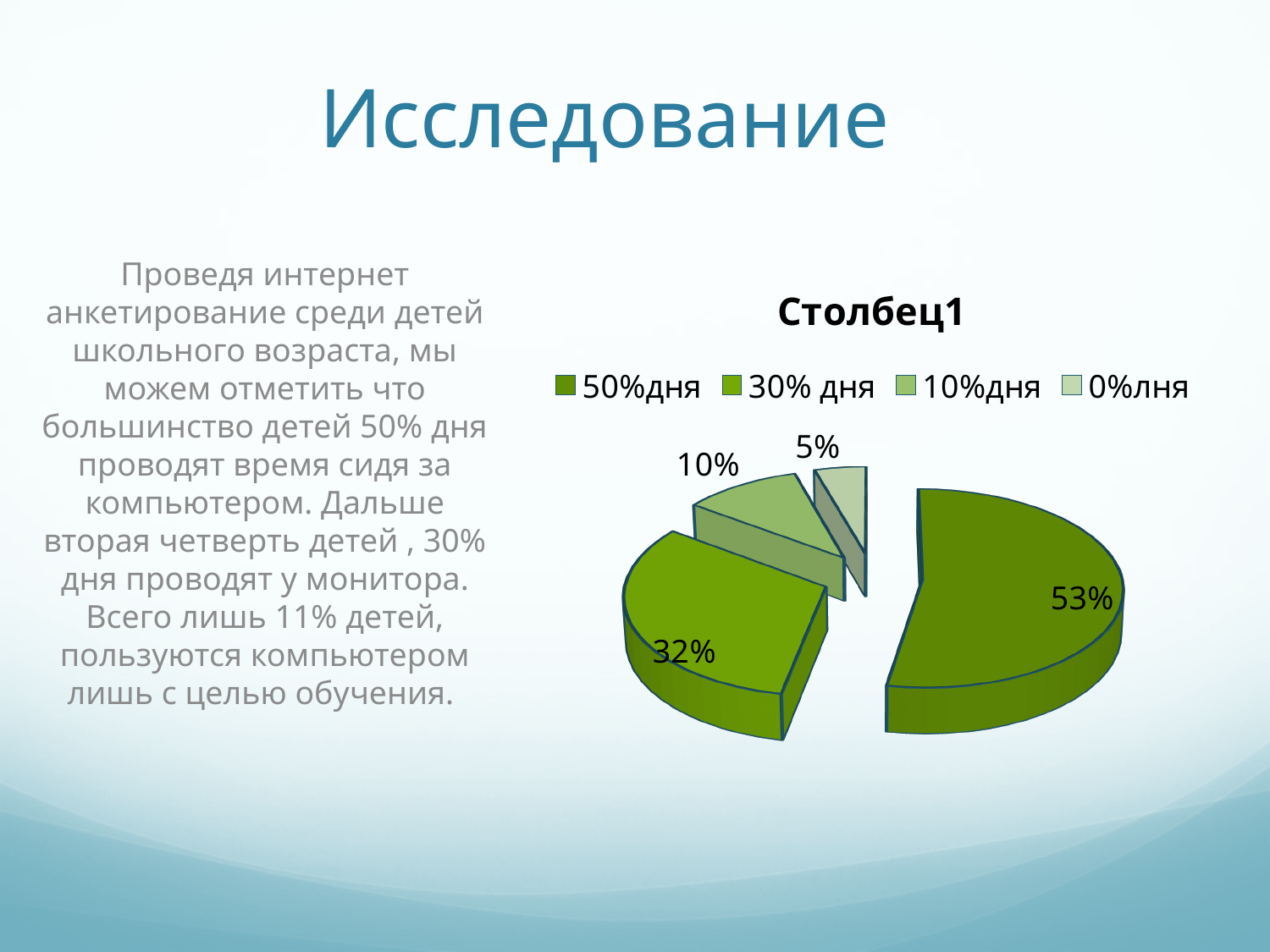
What share of the pie does the "0%лня" slice have? 5% What share of the pie does the "50%дня" slice have? 53% What share of the pie does the "30% дня" slice have? 32% Which slice of the pie chart is the smallest? 0%лня What kind of chart is shown on the slide? pie chart How many entries does the legend of the pie chart list? 4 Which slice is larger, "10%дня" or "0%лня"? 10%дня What is the difference in percentage points between the "50%дня" slice and the "30% дня" slice? 21 How many slices does the pie chart have? 4 What is the title of the pie chart? Столбец1 Which slice of the pie chart is the largest? 50%дня